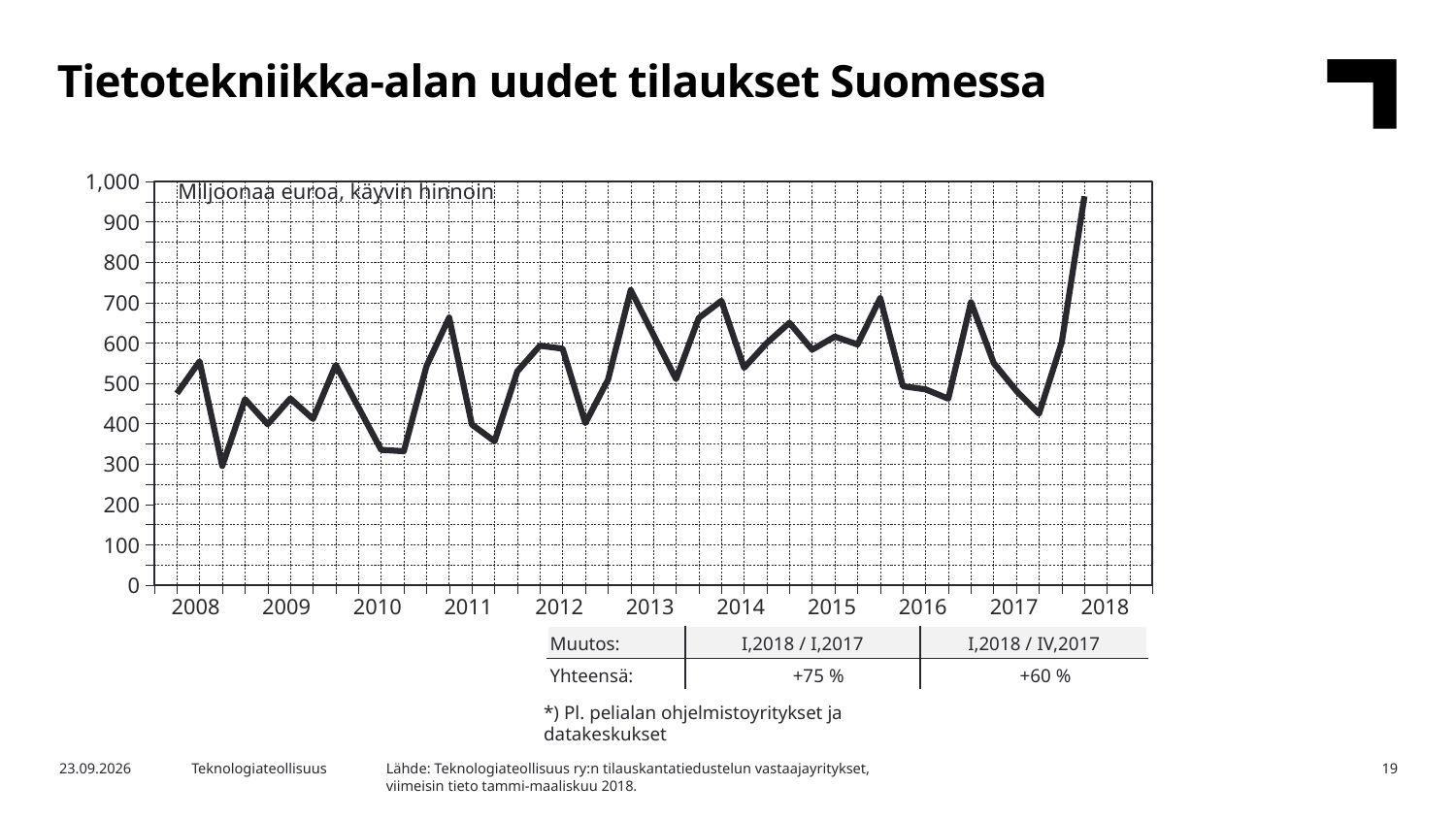
Is the lowest value in 2010 greater or less than 400? less Does the line rise or fall between the end of 2017 and the last point in 2018? rise In which year does the line reach its highest point? 2018 According to the table below the chart, what is the change for I,2018 / I,2017? +75 % Is the peak value reached in 2013 greater or less than 700? greater What unit label is printed inside the chart area? Miljoonaa euroa, käyvin hinnoin How many years are labelled on the x axis? 11 Is the value at the final point of the line (2018) greater or less than 900? greater According to the table below the chart, what is the change for I,2018 / IV,2017? +60 % What is the title of the chart on the slide? Tietotekniikka-alan uudet tilaukset Suomessa What kind of chart is shown on the slide? line chart